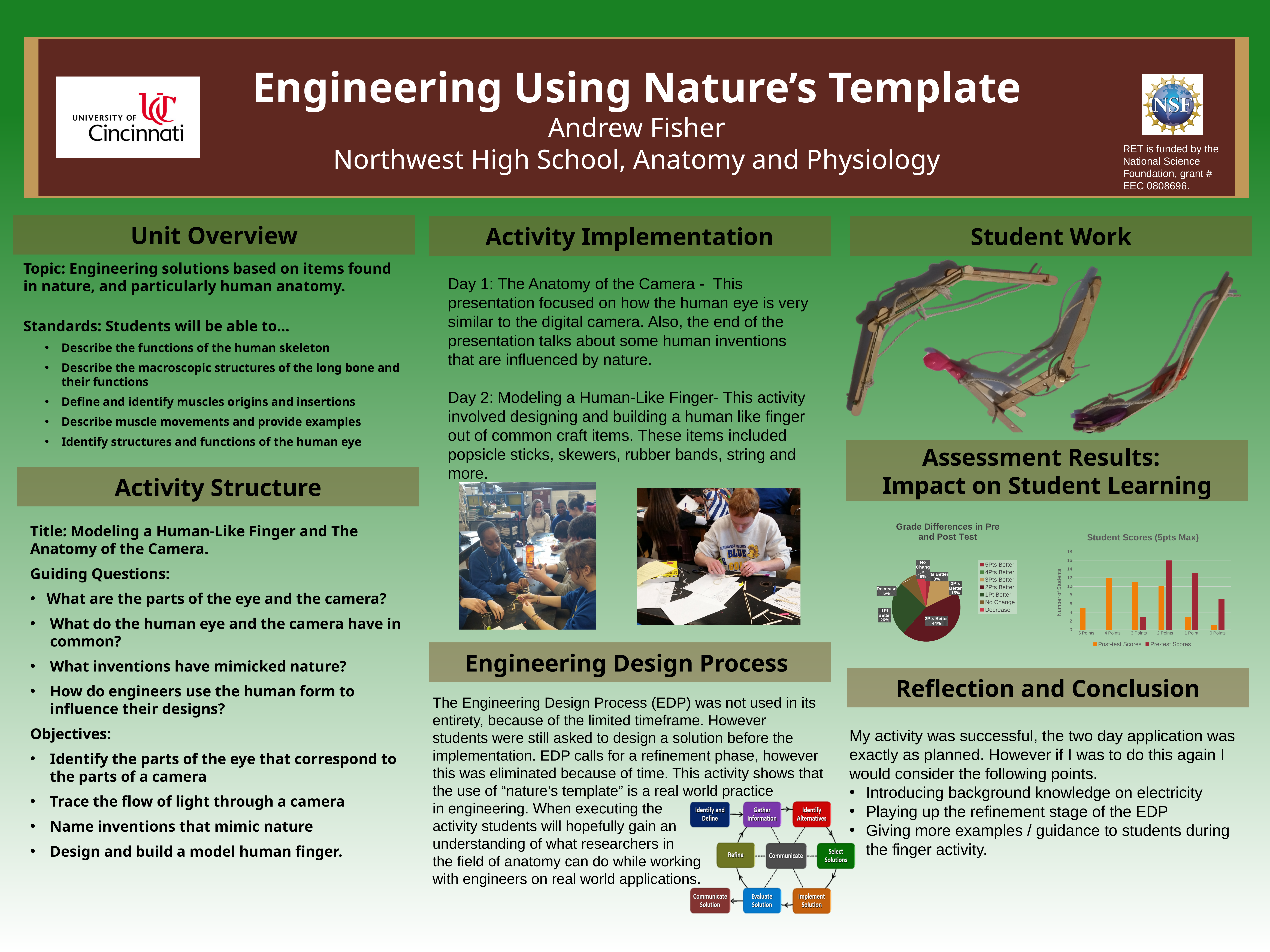
How many score categories are shown on the x axis of the 'Student Scores (5pts Max)' chart? 6 In the 'Grade Differences in Pre and Post Test' chart, what percentage of students scored 2Pts Better? 44% What kind of chart is 'Grade Differences in Pre and Post Test'? Pie chart In the 'Grade Differences in Pre and Post Test' chart, what percentage of students showed No Change? 8% How many series does the legend of the 'Student Scores (5pts Max)' chart list? 2 What kind of chart is 'Student Scores (5pts Max)'? Bar chart In the 'Student Scores (5pts Max)' chart, which series has the taller bar for 4 Points, Post-test Scores or Pre-test Scores? Post-test Scores In the 'Grade Differences in Pre and Post Test' chart, which is larger, the 1Pt Better slice or the 3Pts Better slice? 1Pt Better In the 'Grade Differences in Pre and Post Test' chart, what percentage of students had a Decrease? 5% In the 'Grade Differences in Pre and Post Test' chart, which labelled slice is the largest? 2Pts Better In the 'Grade Differences in Pre and Post Test' chart, what is the difference in percentage points between 1Pt Better and 3Pts Better? 11 In the 'Student Scores (5pts Max)' chart, is the Pre-test Scores value for 2 Points greater or less than 14? greater